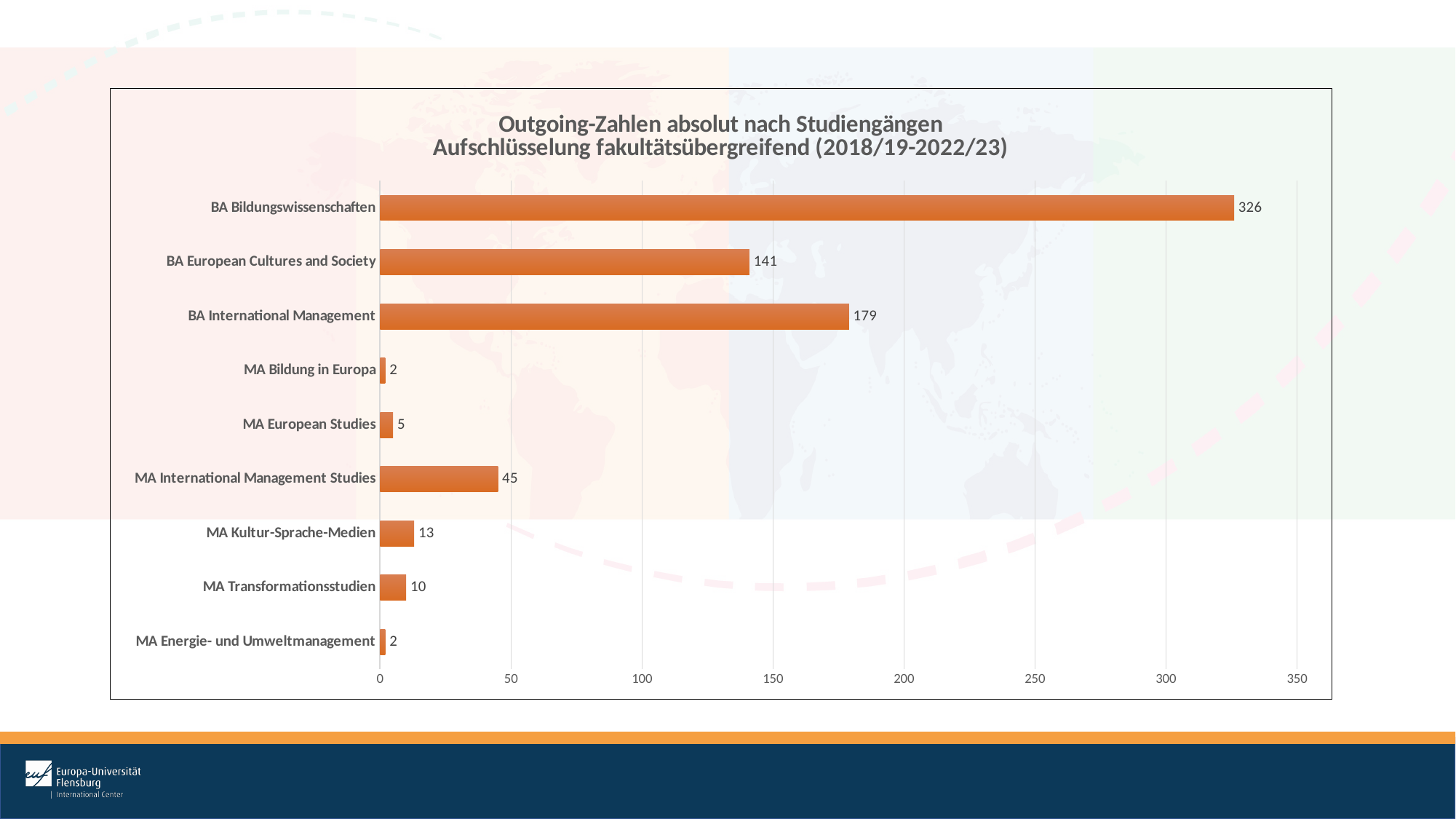
What is the value for MA Kultur-Sprache-Medien? 13 What is the value for BA Bildungswissenschaften? 326 What is the value for MA International Management Studies? 45 What is the title of the chart? Outgoing-Zahlen absolut nach Studiengängen Aufschlüsselung fakultätsübergreifend (2018/19-2022/23) Is the value for BA International Management greater or less than 150? greater How many categories are shown in the chart? 9 Which category has the highest value? BA Bildungswissenschaften What is the value for BA European Cultures and Society? 141 What kind of chart is shown on the slide? bar chart What is the difference between BA Bildungswissenschaften and BA International Management? 147 What is the difference between BA International Management and BA European Cultures and Society? 38 Which is larger, MA Transformationsstudien or MA European Studies? MA Transformationsstudien